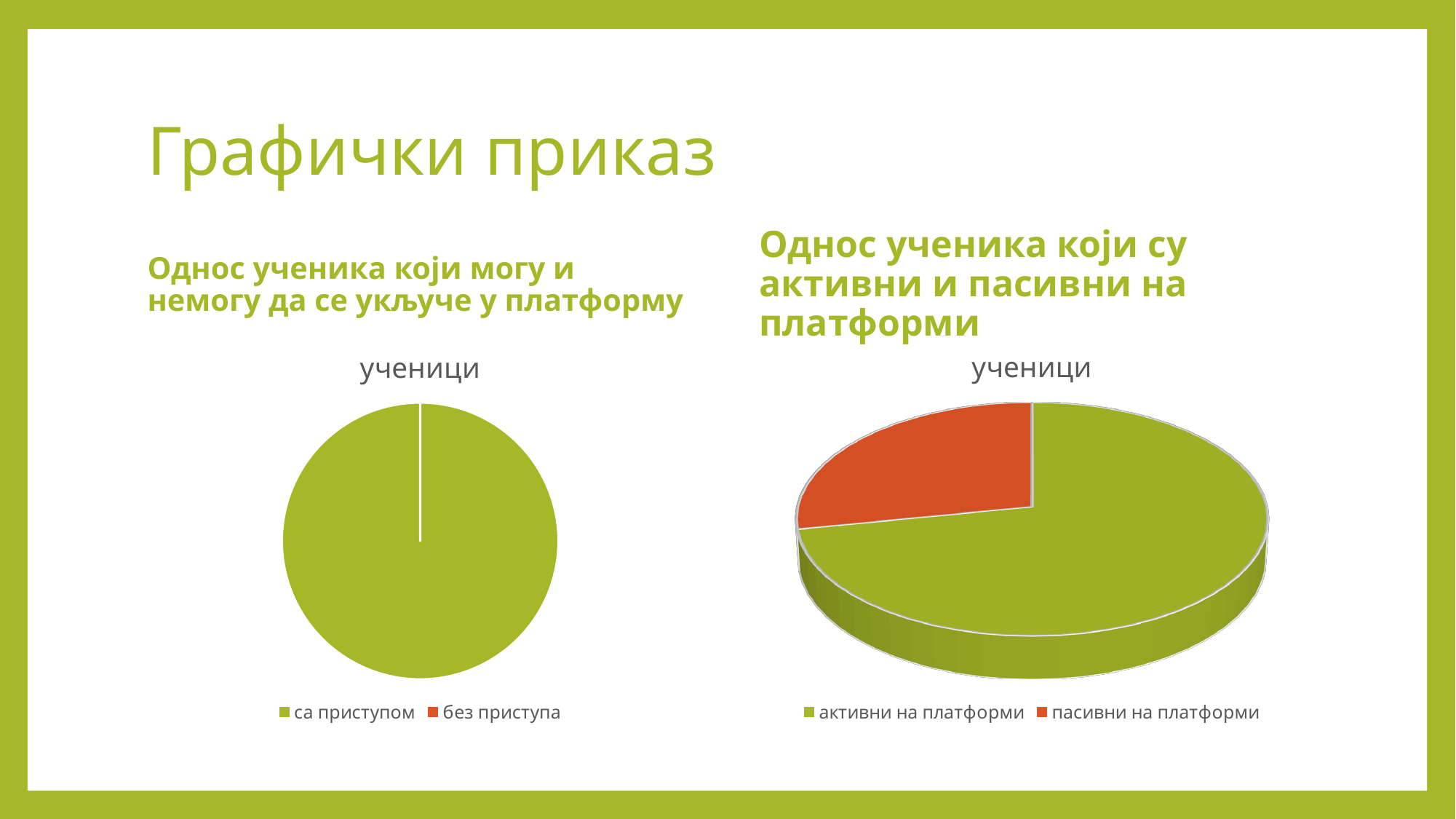
In the right pie chart, how many entries does the legend list? 2 In the right pie chart, which category has the largest slice? активни на платформи In the left pie chart, which category has the smallest share? без приступа What is the chart title shown above both pie charts? ученици In the right pie chart, which category has the smallest slice? пасивни на платформи In the left pie chart, which category takes up the largest share of the pie? са приступом In the right pie chart, what colour is the slice for "пасивни на платформи"? red In the left pie chart, which is larger: "са приступом" or "без приступа"? са приступом In the left pie chart, how many entries does the legend list? 2 What kind of chart is the right chart under "Однос ученика који су активни и пасивни на платформи"? pie chart What kind of chart is the left chart titled "ученици" under "Однос ученика који могу и немогу да се укључе у платформу"? pie chart In the right pie chart, which is larger: the slice for "активни на платформи" or the slice for "пасивни на платформи"? активни на платформи